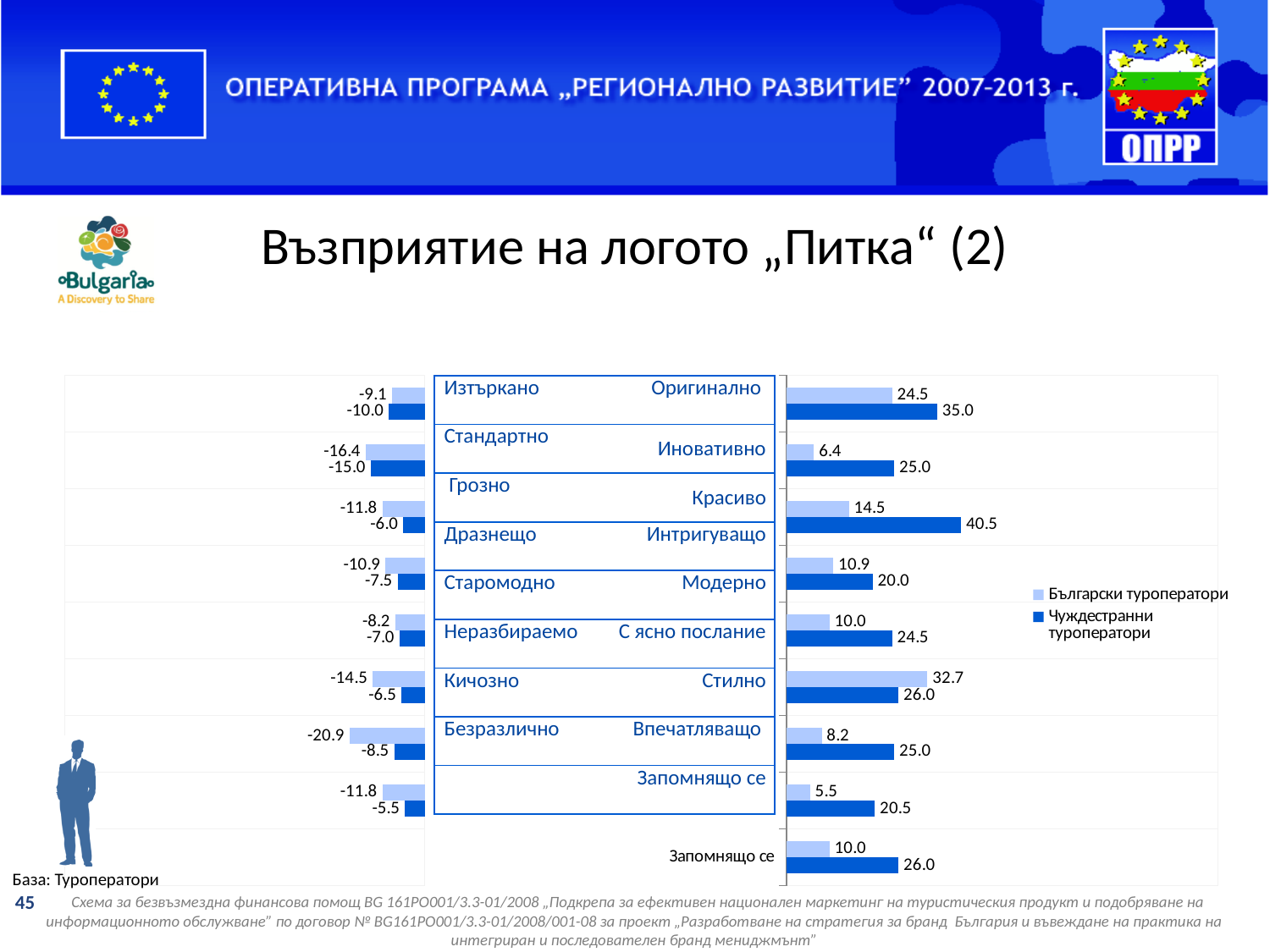
In the right-hand chart, what is the value for Оригинално for Български туроператори? 24.5 In the right-hand chart, which category has the highest value for Български туроператори? С ясно послание In the right-hand chart, which category has the lowest value for Български туроператори? Впечатляващо In the right-hand chart, which category has the highest value for Чуждестранни туроператори? Красиво In the left-hand chart, what is the value for Стандартно for Чуждестранни туроператори? -15.0 What kind of chart is shown on the slide? Bar chart How many series does the legend list? 2 In the right-hand chart, which is larger for Иновативно: the value for Български туроператори or for Чуждестранни туроператори? Чуждестранни туроператори In the left-hand chart, what is the value for Кичозно for Български туроператори? -20.9 Which series is shown in dark blue in the legend? Чуждестранни туроператори In the right-hand chart, what is the value for Красиво for Чуждестранни туроператори? 40.5 In the right-hand chart, what is the difference between the Чуждестранни туроператори and Български туроператори values for Красиво? 26.0